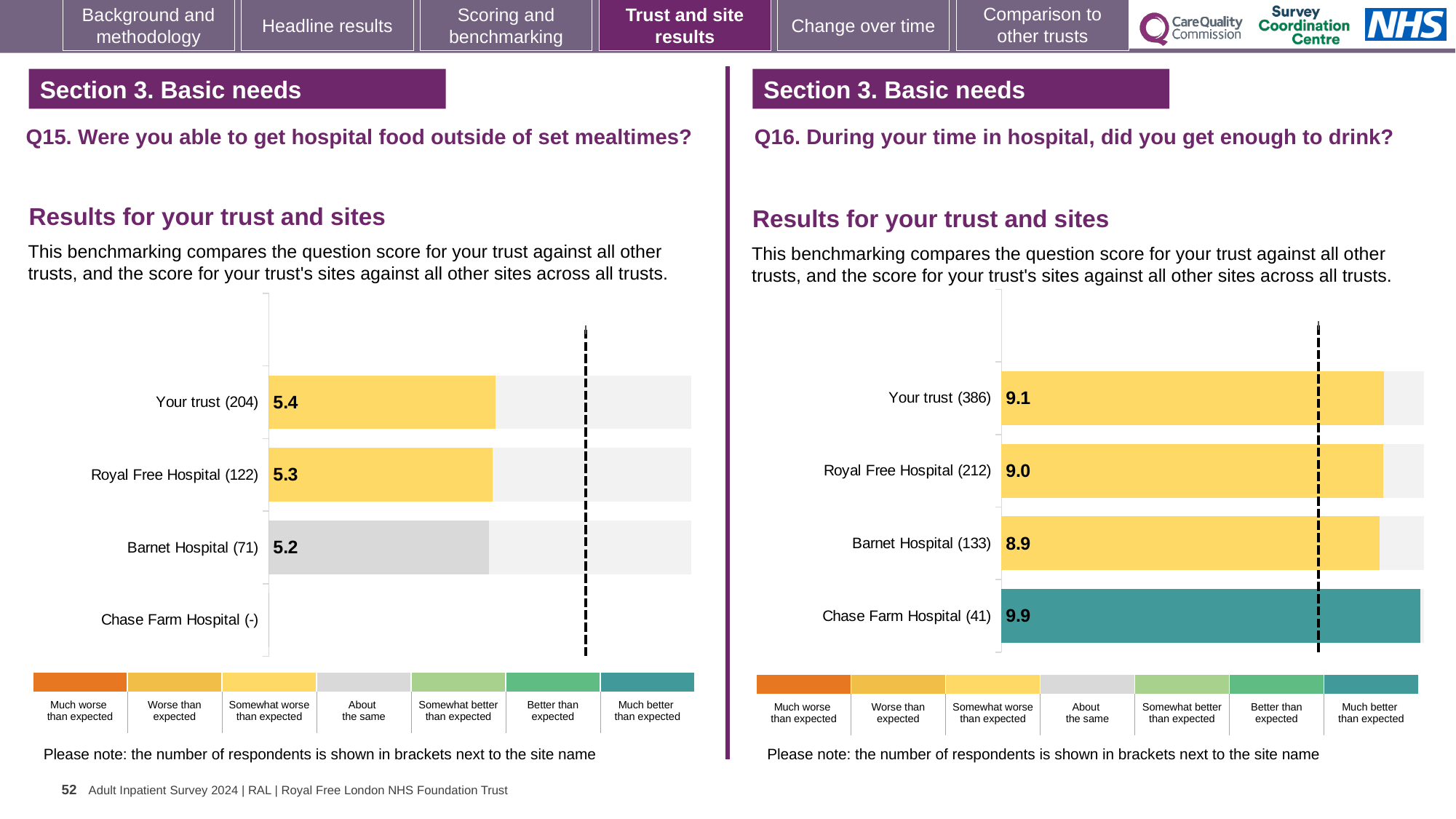
In the Q15 chart (left), what is the score for Your trust? 5.4 In the Q15 chart (left), what is the score for Barnet Hospital? 5.2 In the Q15 chart (left), what is the difference between the scores for Your trust and Royal Free Hospital? 0.1 In the Q16 chart (right), what is the score for Chase Farm Hospital? 9.9 In the Q16 chart (right), which site or trust has the highest score? Chase Farm Hospital In the Q16 chart (right), which has the larger score, Your trust or Chase Farm Hospital? Chase Farm Hospital In the Q16 chart (right), what is the difference between the scores for Chase Farm Hospital and Barnet Hospital? 1.0 In the Q15 chart (left), among the rows with a printed score, which has the lowest score? Barnet Hospital How many rows (trust and sites) are listed in the Q15 chart (left)? 4 In the Q16 chart (right), what is the score for Royal Free Hospital? 9.0 In the Q16 chart (right), which site or trust has the lowest score? Barnet Hospital In the Q16 chart (right), which benchmarking category does the colour of the Chase Farm Hospital bar indicate? Much better than expected